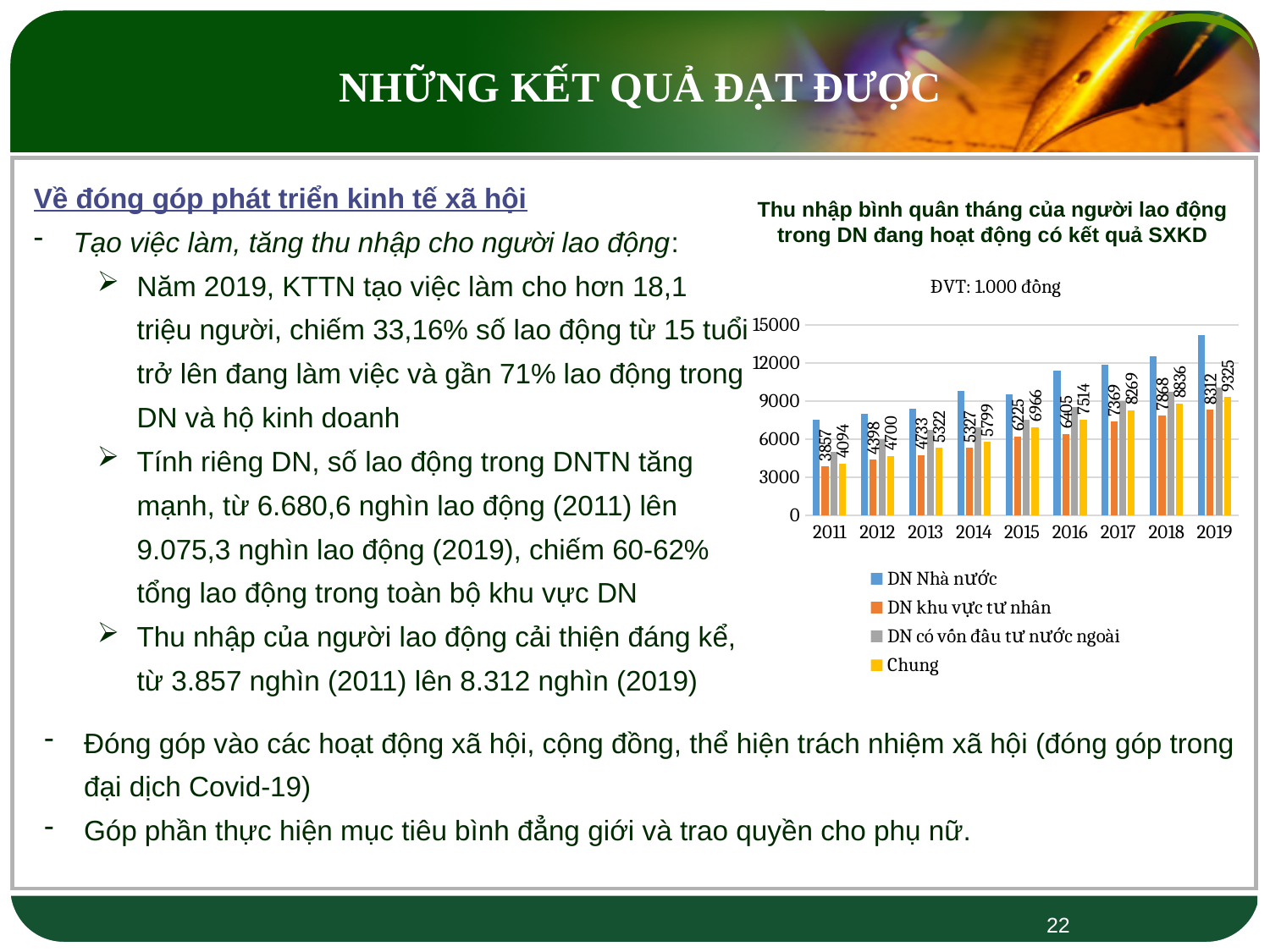
How many years are shown on the x axis of the chart? 9 What is the labelled value for DN khu vực tư nhân in 2019? 8312 By how much did the labelled value for DN khu vực tư nhân increase from 2011 to 2019? 4455 Do the values for DN khu vực tư nhân rise or fall from 2011 to 2019? rise Which is larger for DN khu vực tư nhân: the value in 2015 or the value in 2016? 2016 How many series does the chart legend list? 4 Which series has the highest bar in 2019? DN Nhà nước What is the labelled value for DN khu vực tư nhân in 2011? 3857 What kind of chart is shown on the slide? bar chart What is the labelled value for DN khu vực tư nhân in 2014? 5327 Is the value for DN Nhà nước in 2019 greater or less than 12000? greater What unit is stated for the chart values? 1.000 đồng